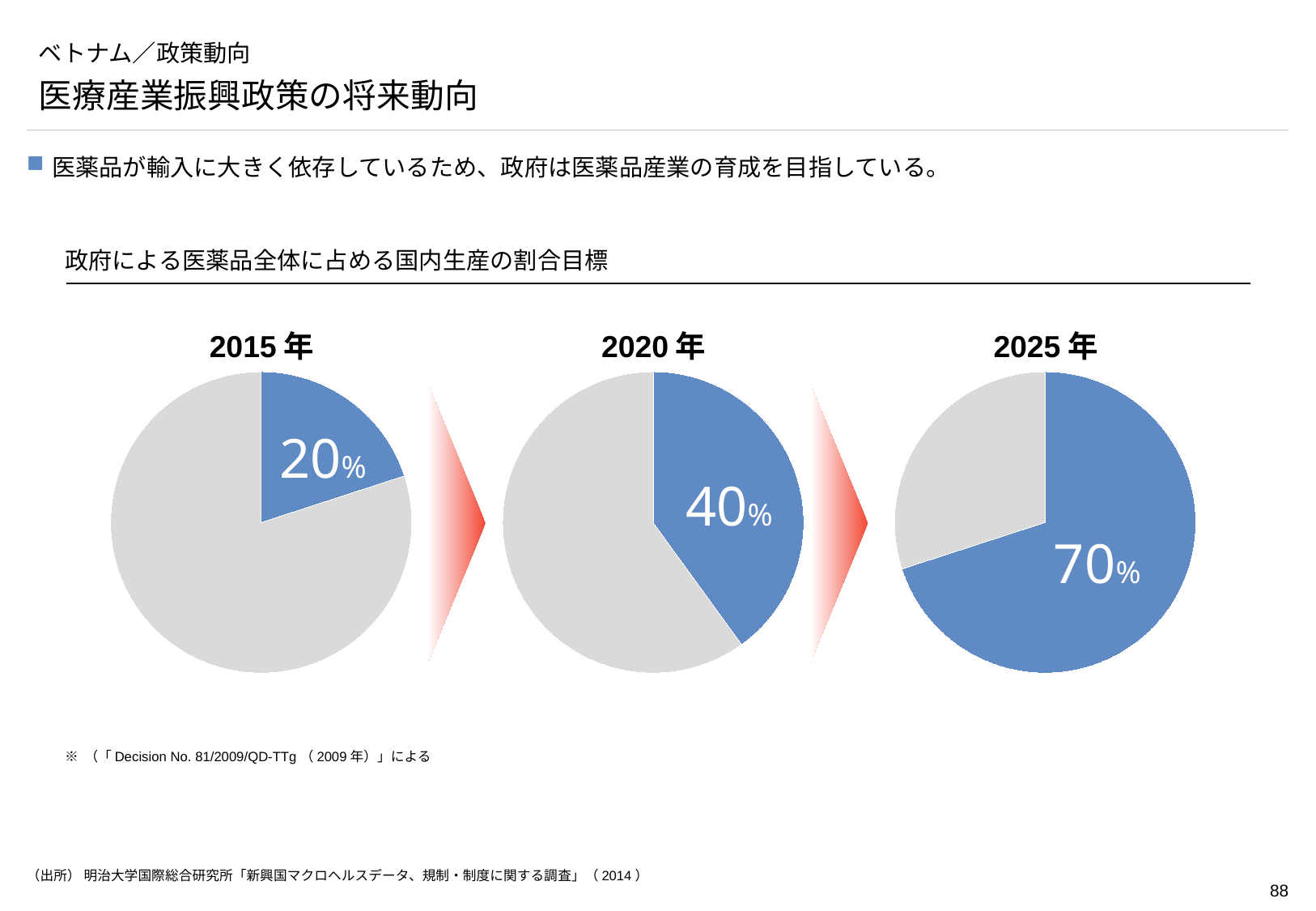
In the 2020年 pie chart, what percentage is shown for the blue slice? 40% In the 2015年 pie chart, what percentage is shown for the blue slice? 20% Is the blue slice larger in the 2020年 pie chart or in the 2025年 pie chart? 2025年 What type of chart is used to show the domestic production share targets on this slide? Pie chart Do the percentages shown in the pie charts rise or fall from 2015年 to 2025年? Rise What is the difference between the percentage shown in the 2025年 pie chart and the percentage shown in the 2015年 pie chart? 50% Which of the three pie charts (2015年, 2020年, 2025年) shows the lowest domestic production share? 2015年 How many pie charts are shown on the slide? 3 What is the difference between the percentage shown in the 2020年 pie chart and the percentage shown in the 2015年 pie chart? 20% Which of the three pie charts (2015年, 2020年, 2025年) shows the highest domestic production share? 2025年 What is the title given above the three pie charts? 政府による医薬品全体に占める国内生産の割合目標 In the 2025年 pie chart, what percentage is shown for the blue slice? 70%